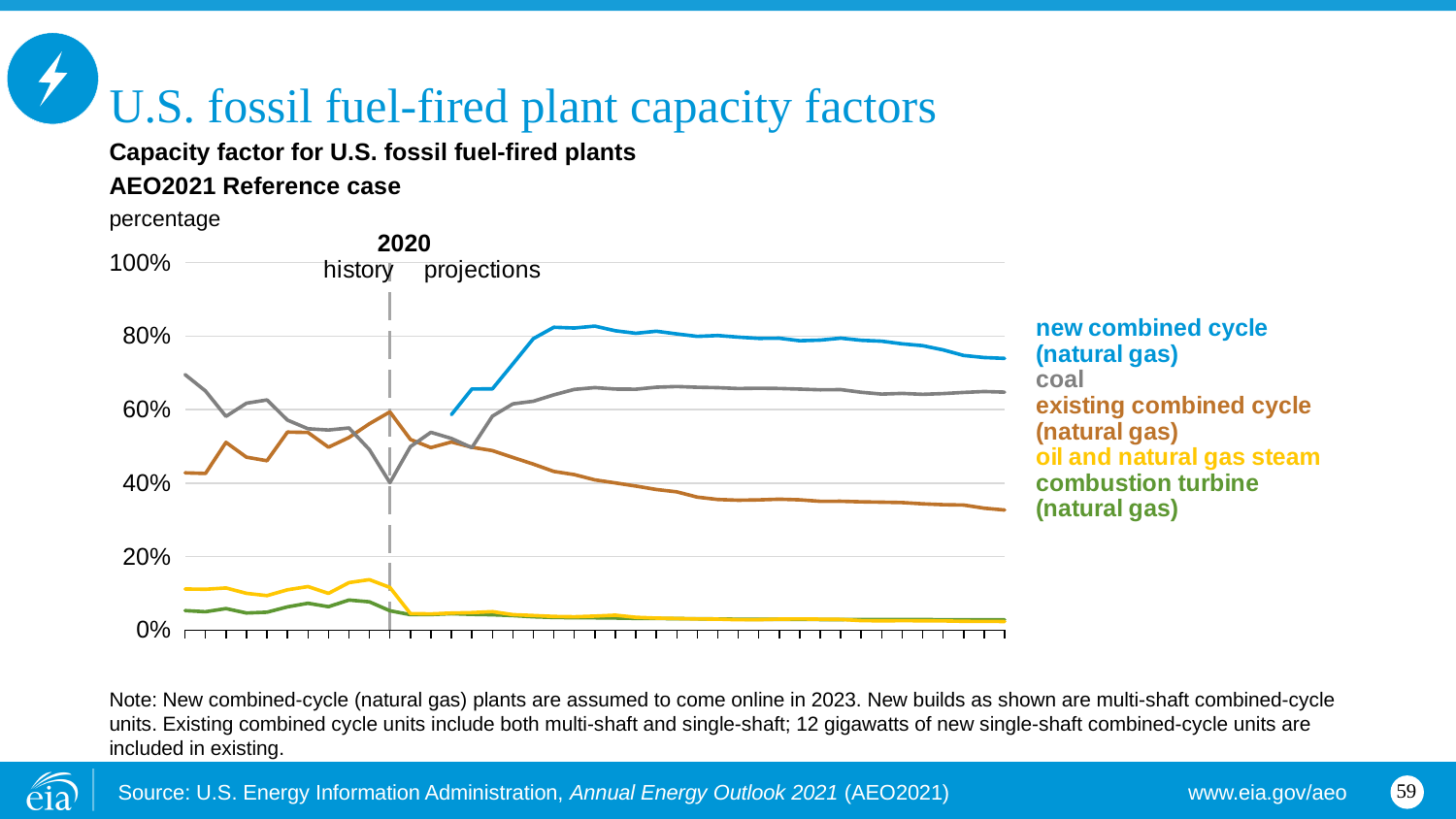
Is the capacity factor for existing combined cycle (natural gas) at the end of the projection period greater or less than 40%? less Is the capacity factor for combustion turbine (natural gas) at the end of the projection period greater or less than 20%? less Is the capacity factor for coal at the end of the projection period greater or less than 60%? greater How many series does the legend list? 5 What kind of chart is shown on the slide? line chart Which series has the highest capacity factor at the end of the projection period? new combined cycle (natural gas) What is the unit shown on the vertical axis of the chart? percentage Does the capacity factor for existing combined cycle (natural gas) rise or fall over the projection period? fall What year marks the boundary between history and projections on the chart? 2020 At the end of the projection period, which has the larger capacity factor: coal or existing combined cycle (natural gas)? coal